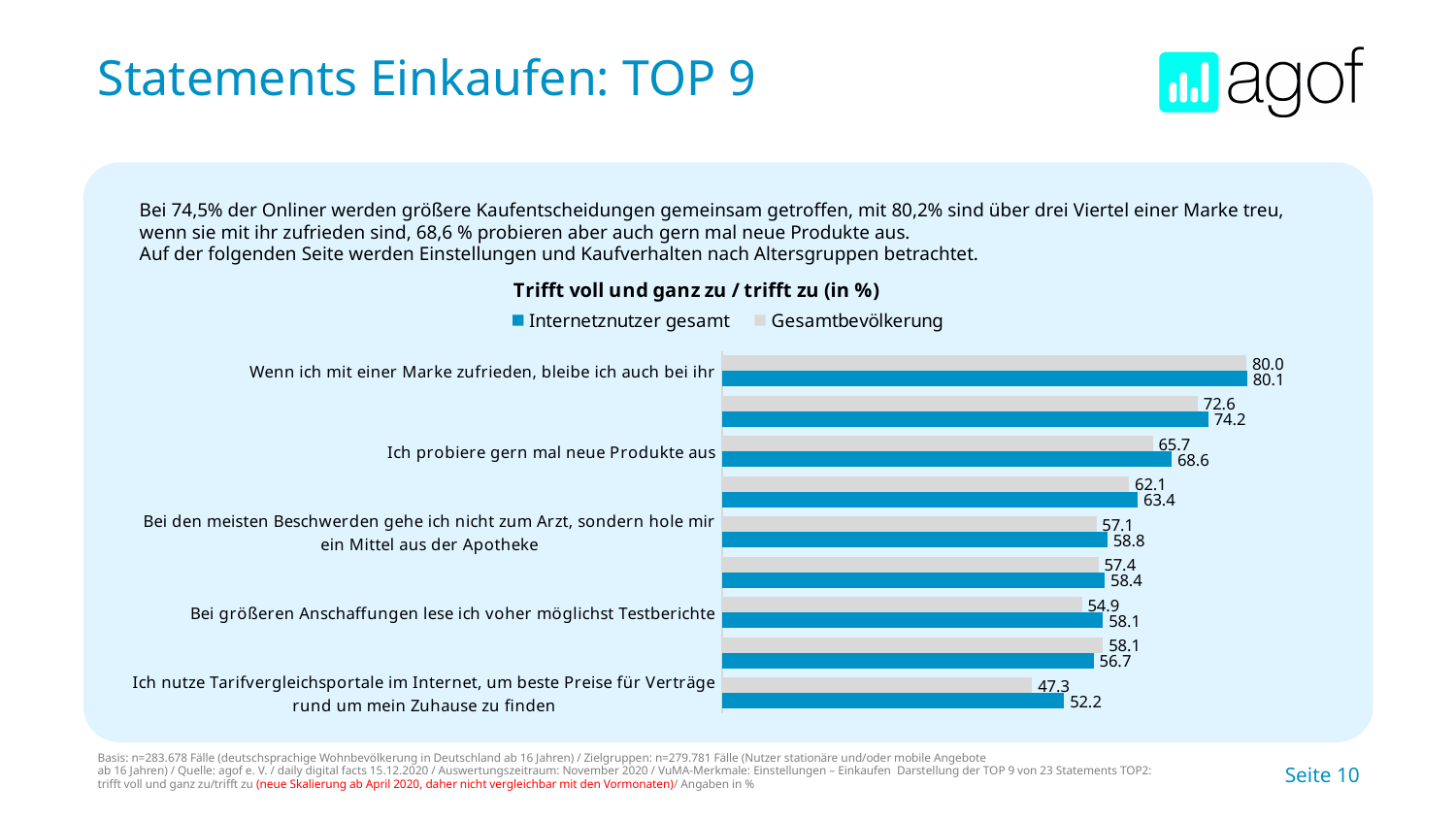
What is the value for Internetznutzer gesamt for "Ich nutze Tarifvergleichsportale im Internet, um beste Preise für Verträge rund um mein Zuhause zu finden"? 52.2 What kind of chart is shown on the slide? Bar chart What is the value for Gesamtbevölkerung for "Ich probiere gern mal neue Produkte aus"? 65.7 What is the value for Gesamtbevölkerung for "Bei größeren Anschaffungen lese ich voher möglichst Testberichte"? 54.9 How many statements (categories) are plotted in the chart? 9 For "Bei den meisten Beschwerden gehe ich nicht zum Arzt, sondern hole mir ein Mittel aus der Apotheke", which series has the larger value, Internetznutzer gesamt or Gesamtbevölkerung? Internetznutzer gesamt What is the value for Internetznutzer gesamt for "Ich probiere gern mal neue Produkte aus"? 68.6 What is the difference between Internetznutzer gesamt and Gesamtbevölkerung for "Bei größeren Anschaffungen lese ich voher möglichst Testberichte"? 3.2 What is the difference between Internetznutzer gesamt and Gesamtbevölkerung for "Ich nutze Tarifvergleichsportale im Internet, um beste Preise für Verträge rund um mein Zuhause zu finden"? 4.9 Which statement has the highest value for Internetznutzer gesamt? Wenn ich mit einer Marke zufrieden, bleibe ich auch bei ihr Which statement has the lowest value for Gesamtbevölkerung? Ich nutze Tarifvergleichsportale im Internet, um beste Preise für Verträge rund um mein Zuhause zu finden How many series does the legend list? 2